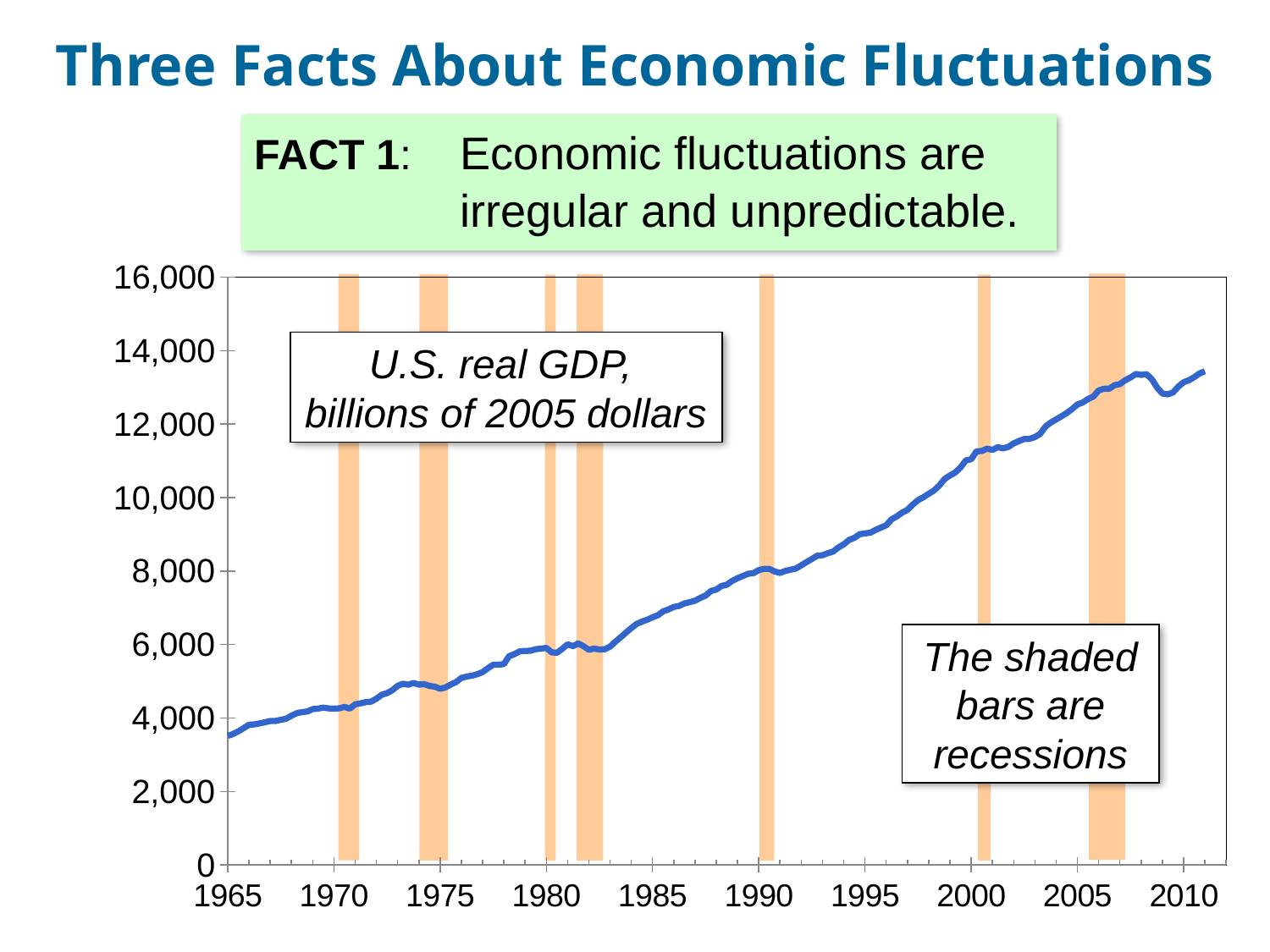
Overall, does U.S. real GDP rise or fall from 1965 to 2010 in the chart? rise Is the value of U.S. real GDP in 1985 greater or less than 6,000? greater Is the value of U.S. real GDP in 2000 greater or less than 10,000? greater Is the value of U.S. real GDP in 1995 greater or less than 8,000? greater How many shaded recession bars are shown on the chart? 7 What kind of chart is shown on the slide? line chart What do the shaded bars on the chart represent? recessions In what units is U.S. real GDP measured on the chart? billions of 2005 dollars Which year has the higher U.S. real GDP, 1970 or 2005? 2005